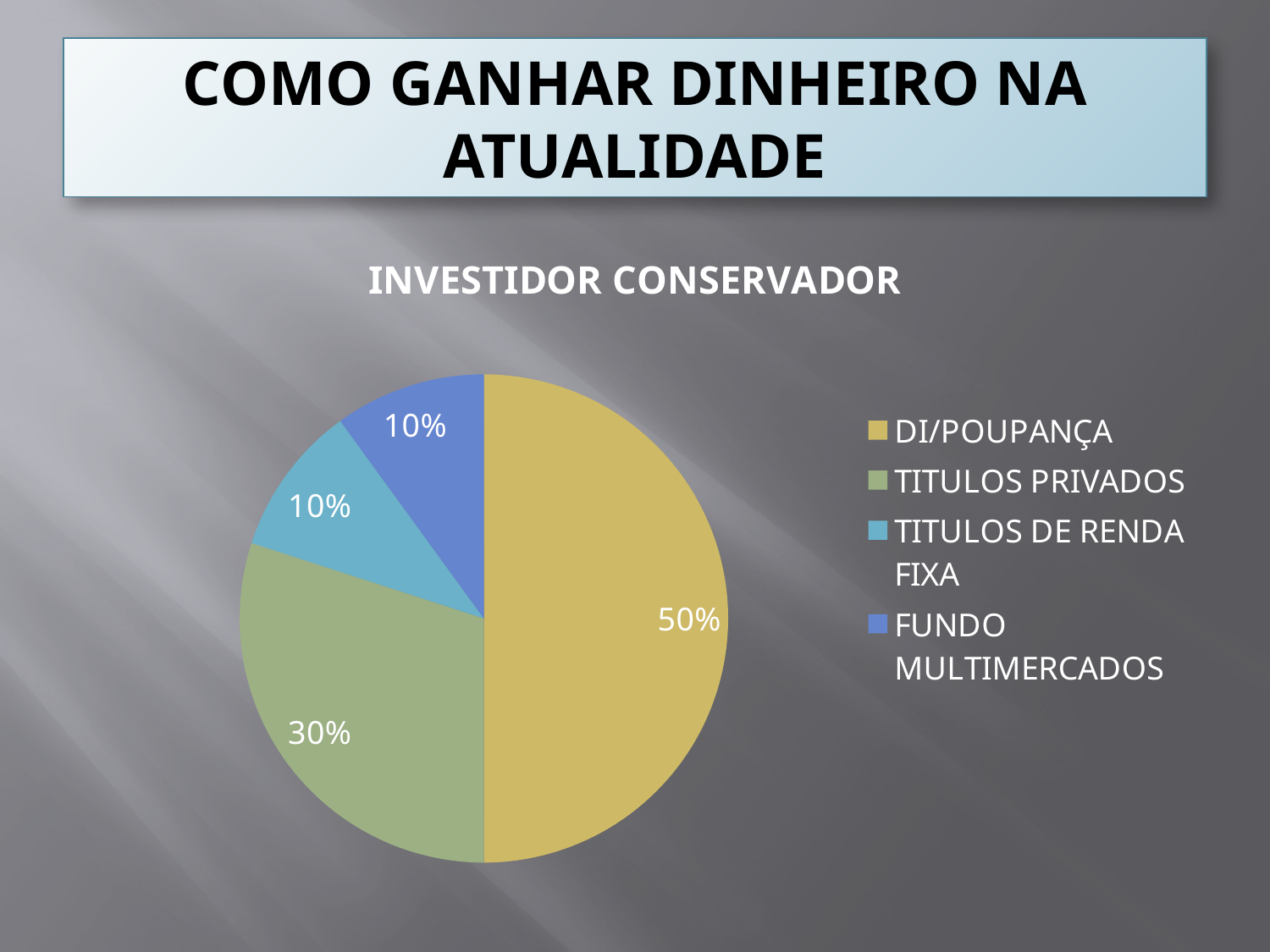
What type of chart is shown on the slide? pie chart What is the title of the chart? INVESTIDOR CONSERVADOR What share of the pie does TITULOS DE RENDA FIXA represent? 10% What share of the pie does DI/POUPANÇA represent? 50% What share of the pie does FUNDO MULTIMERCADOS represent? 10% Which category has the largest slice of the pie? DI/POUPANÇA Which is larger, the share for TITULOS PRIVADOS or the share for FUNDO MULTIMERCADOS? TITULOS PRIVADOS What colour is the DI/POUPANÇA slice? yellow What is the difference between the DI/POUPANÇA share and the TITULOS PRIVADOS share? 20% What share of the pie does TITULOS PRIVADOS represent? 30% How many slices does the pie chart have? 4 How many entries does the legend list? 4